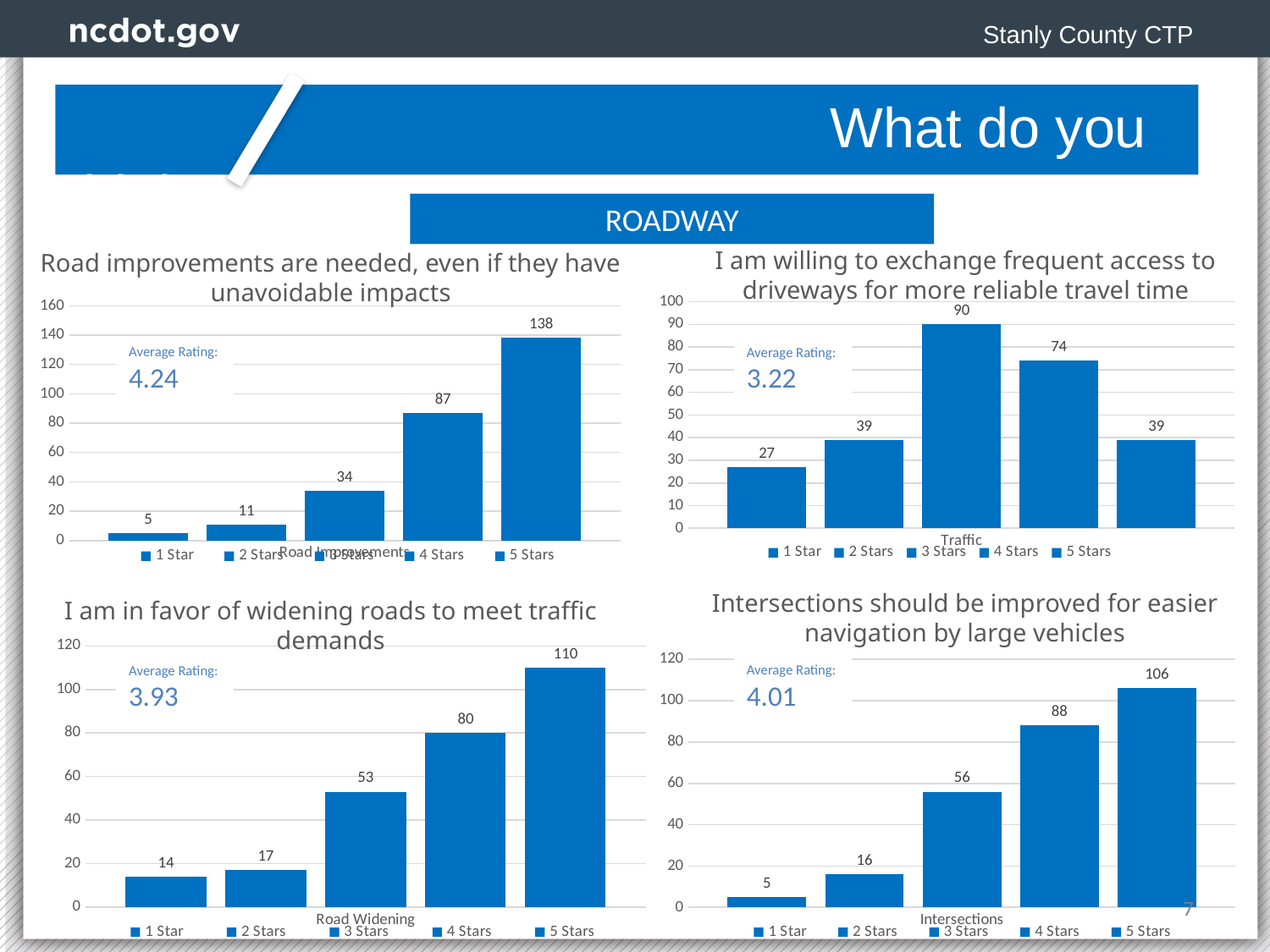
How many series does the legend list in the chart titled "I am in favor of widening roads to meet traffic demands"? 5 In the chart titled "I am willing to exchange frequent access to driveways for more reliable travel time", what is the difference between the values for 3 Stars and 4 Stars? 16 In the chart titled "Intersections should be improved for easier navigation by large vehicles", what is the value for 4 Stars? 88 In the chart titled "Intersections should be improved for easier navigation by large vehicles", which is larger, the value for 2 Stars or the value for 3 Stars? 3 Stars What kind of chart is the chart titled "Road improvements are needed, even if they have unavoidable impacts"? bar chart In the chart titled "I am in favor of widening roads to meet traffic demands", is the value for 5 Stars greater or less than 100? greater In the chart titled "Road improvements are needed, even if they have unavoidable impacts", which rating has the lowest value? 1 Star In the chart titled "I am willing to exchange frequent access to driveways for more reliable travel time", what is the value for 1 Star? 27 In the chart titled "Road improvements are needed, even if they have unavoidable impacts", what is the value for 5 Stars? 138 In the chart titled "Intersections should be improved for easier navigation by large vehicles", do the values rise or fall from 1 Star to 5 Stars? rise In the chart titled "I am in favor of widening roads to meet traffic demands", what is the value for 3 Stars? 53 In the chart titled "I am willing to exchange frequent access to driveways for more reliable travel time", which rating has the highest value? 3 Stars